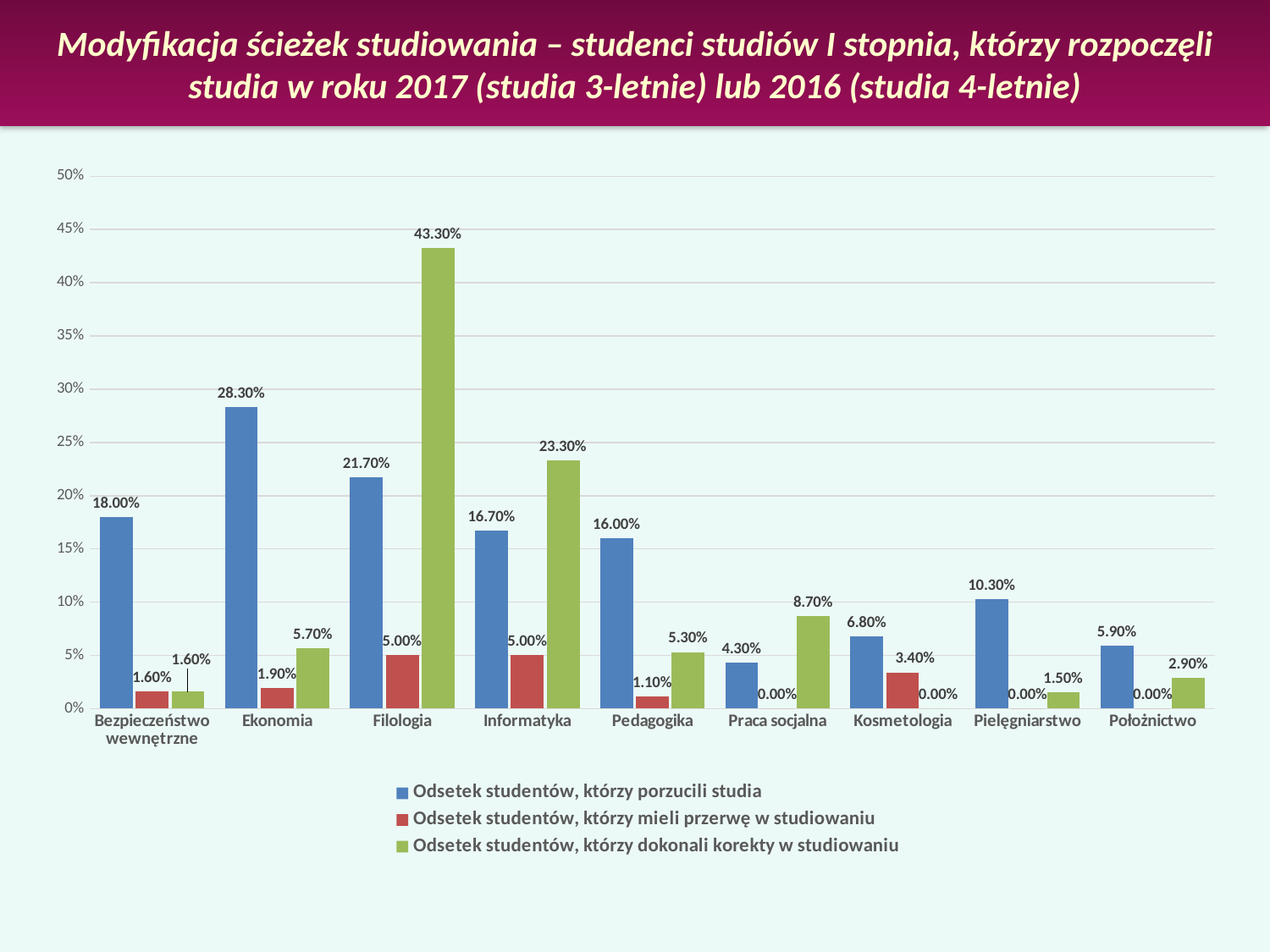
What is the value for Filologia in the series 'Odsetek studentów, którzy dokonali korekty w studiowaniu'? 43.30% What kind of chart is shown on the slide? Bar chart Which field of study has the highest value in the series 'Odsetek studentów, którzy porzucili studia'? Ekonomia Which is larger for Pielęgniarstwo: the share of students who abandoned their studies or the share who made a correction in their studies? Odsetek studentów, którzy porzucili studia What percentage of students in Ekonomia abandoned their studies (Odsetek studentów, którzy porzucili studia)? 28.30% What is the value for Kosmetologia in the series 'Odsetek studentów, którzy mieli przerwę w studiowaniu'? 3.40% Which colour represents the series 'Odsetek studentów, którzy mieli przerwę w studiowaniu'? Red How many fields of study are shown on the x axis? 9 What is the difference between the 'dokonali korekty' values for Filologia and Informatyka? 20.00% How many series does the legend list? 3 Which field of study has the lowest value in the series 'Odsetek studentów, którzy porzucili studia'? Praca socjalna Is the 'porzucili studia' value for Filologia greater or less than 20%? greater